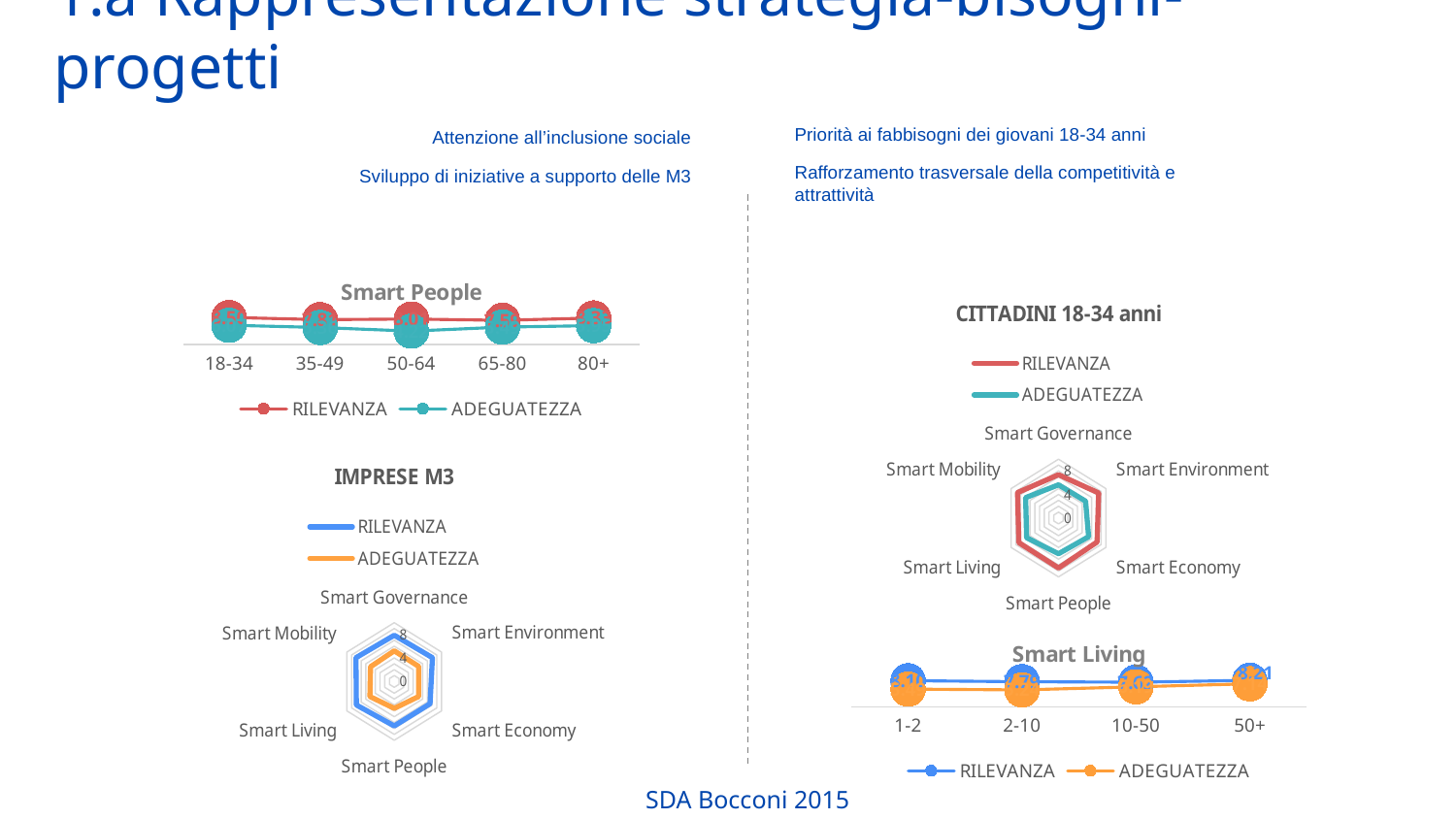
In the 'IMPRESE M3' radar chart, which series has the larger values overall, RILEVANZA or ADEGUATEZZA? RILEVANZA How many axes (categories) does the 'CITTADINI 18-34 anni' radar chart have? 6 What kind of chart is the 'Smart People' chart on the slide? line chart What is the highest tick value shown on the radial axis of the 'CITTADINI 18-34 anni' radar chart? 8 What kind of chart is the 'IMPRESE M3' chart on the slide? radar chart What are the two series listed in the legend of the 'IMPRESE M3' chart? RILEVANZA and ADEGUATEZZA What is the first category on the x axis of the 'Smart Living' chart? 1-2 Which category is at the top of the 'IMPRESE M3' radar chart? Smart Governance In the 'CITTADINI 18-34 anni' radar chart, which series has the larger values overall, RILEVANZA or ADEGUATEZZA? RILEVANZA How many categories are shown on the x axis of the 'Smart Living' chart? 4 How many age categories are shown on the x axis of the 'Smart People' chart? 5 How many series does the legend of the 'Smart Living' chart list? 2